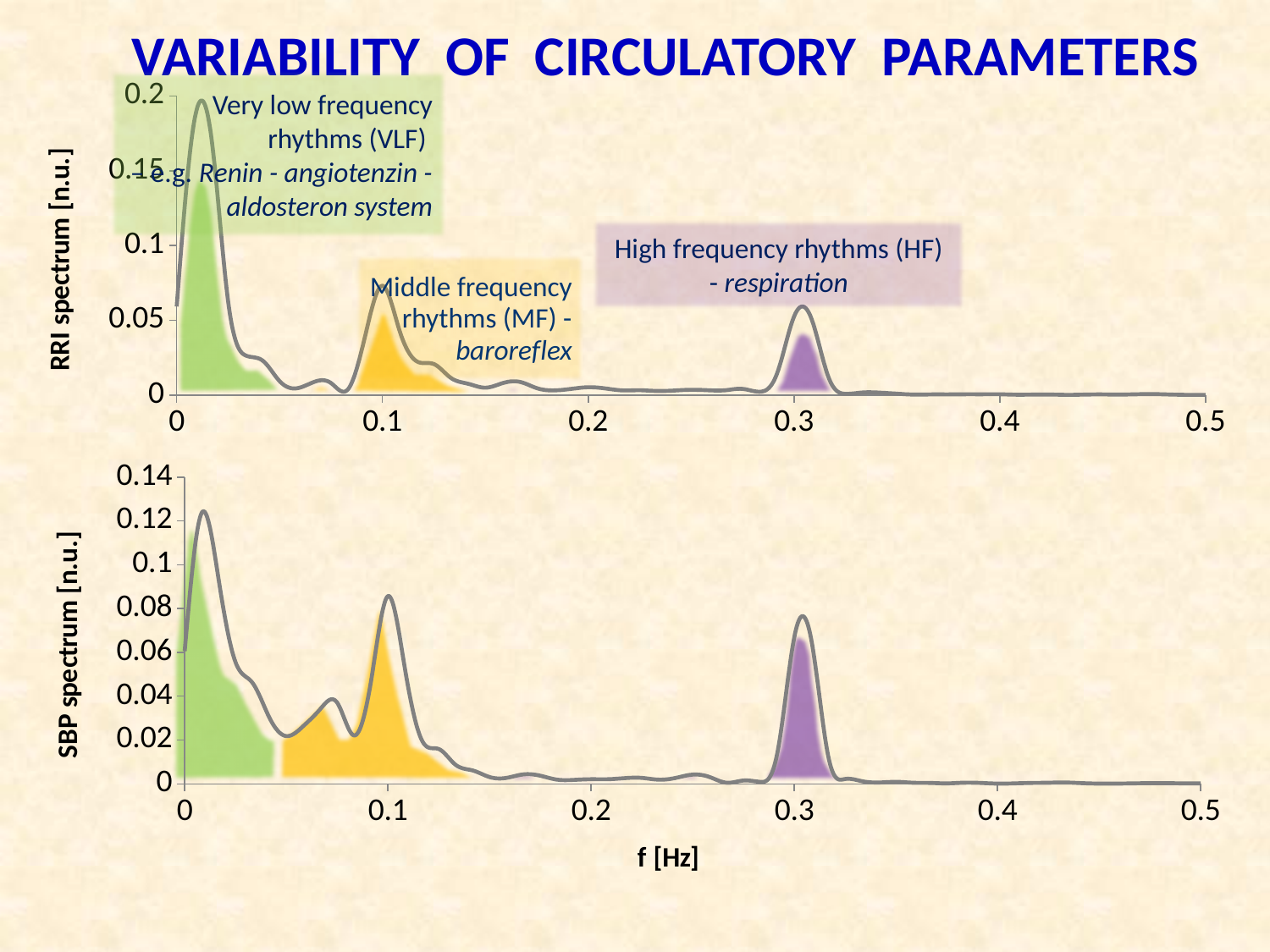
What colour is used to shade the high frequency (HF) band in both charts? purple In the bottom chart (SBP spectrum), is the peak of the VLF band greater or less than 0.1? greater In the top chart (RRI spectrum), is the peak of the HF band near 0.3 Hz greater or less than 0.1? less In the bottom chart (SBP spectrum), is the peak of the HF band near 0.3 Hz greater or less than 0.1? less What is the label of the shared x axis of the two charts? f [Hz] What kind of chart is the top chart (RRI spectrum)? line chart In the top chart (RRI spectrum), which is larger: the VLF peak or the HF peak? the VLF peak In the bottom chart (SBP spectrum), which frequency band contains the highest peak? Very low frequency rhythms (VLF) In the top chart (RRI spectrum), which frequency band contains the highest peak? Very low frequency rhythms (VLF)